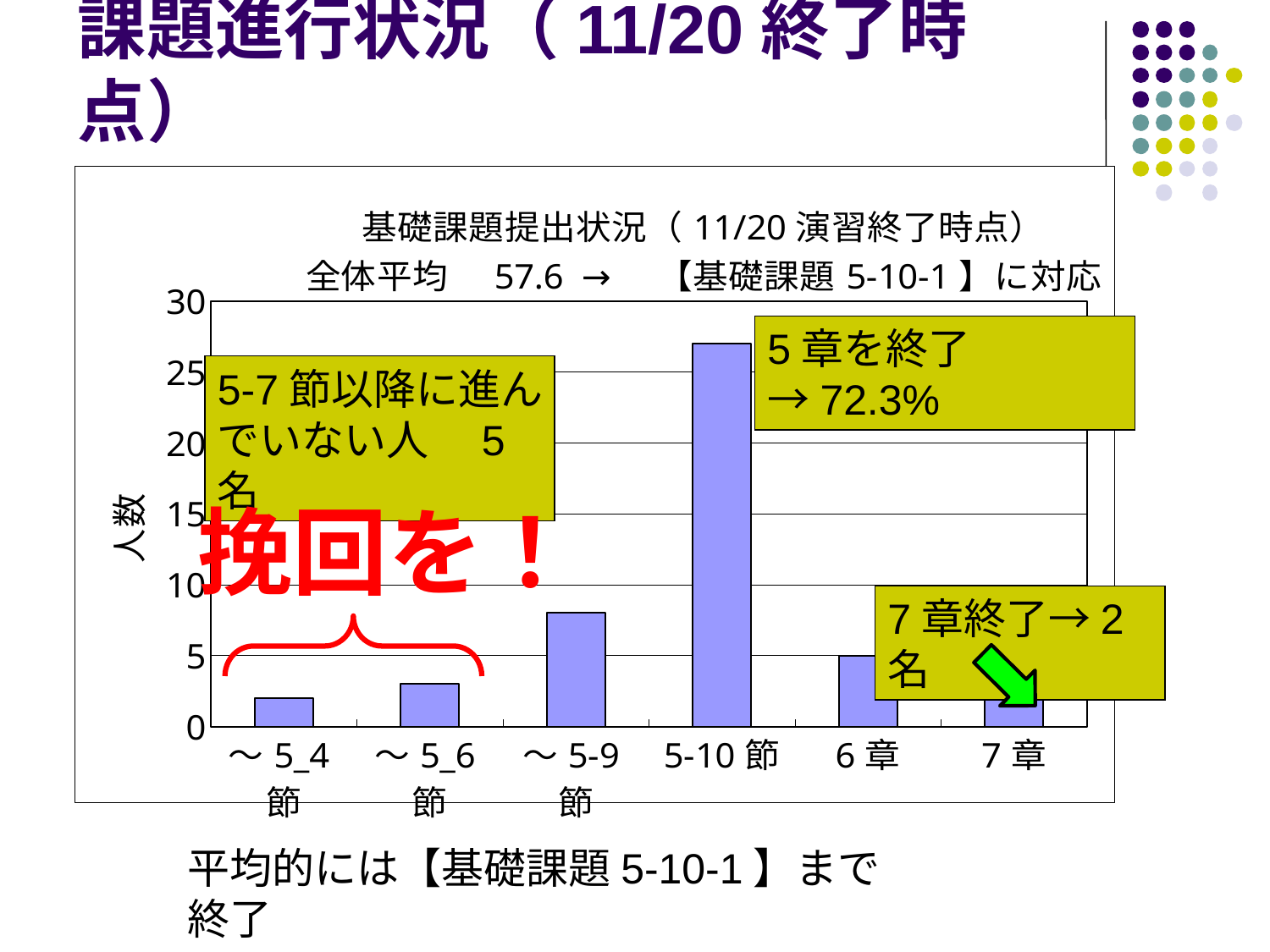
What is the label of the vertical axis? 人数 Is the value for ～5_6 節 greater or less than 5? less Which is larger, the value for 5-10 節 or the value for ～5-9 節? 5-10 節 What kind of chart is shown on the slide? bar chart How many categories are shown on the x axis? 6 Is the value for 5-10 節 greater or less than 25? greater Is the value for ～5-9 節 greater or less than 10? less What overall average (全体平均) is stated above the chart? 57.6 What is the title of the chart? 基礎課題提出状況（11/20 演習終了時点） 全体平均 57.6 → 【基礎課題 5-10-1】に対応 According to the annotation, how many people have finished 7 章? 2 名 Which is larger, the value for ～5-9 節 or the value for 6 章? ～5-9 節 Which category has the highest bar? 5-10 節